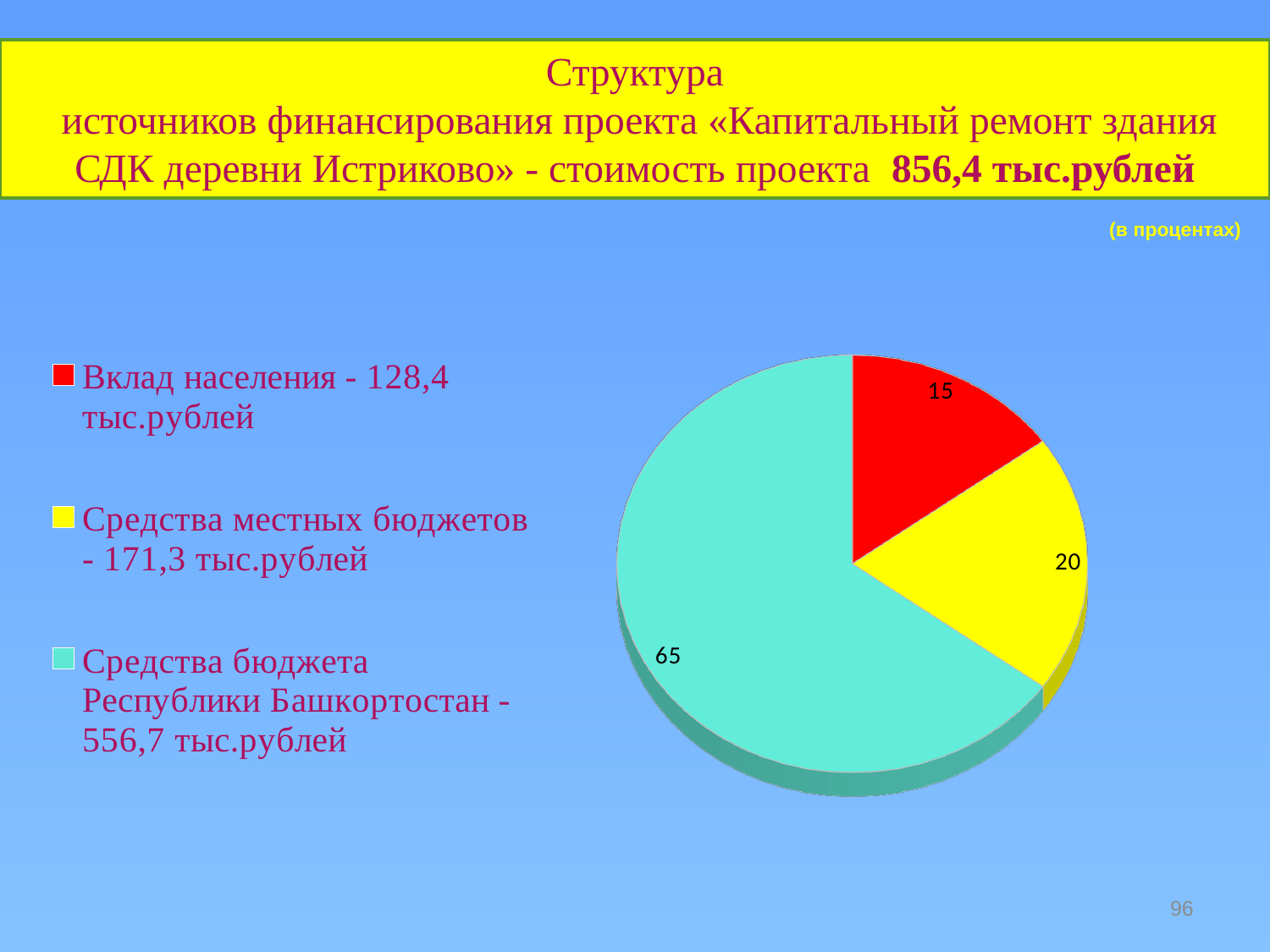
What is the difference in percentage points between the slices for Средства местных бюджетов and Вклад населения? 5 What percentage share does the slice for Средства бюджета Республики Башкортостан have? 65 How many slices does the pie chart have? 3 What kind of chart is shown on the slide? pie chart According to the legend, what amount in тыс.рублей corresponds to Средства бюджета Республики Башкортостан? 556,7 тыс.рублей By how many percentage points does the slice for Средства бюджета Республики Башкортостан exceed the slice for Средства местных бюджетов? 45 What percentage share does the slice for Средства местных бюджетов have? 20 What percentage share does the slice for Вклад населения have? 15 Which funding source has the smallest slice of the pie? Вклад населения Which funding source has the largest slice of the pie? Средства бюджета Республики Башкортостан What colour is the slice for Вклад населения? red Which slice is larger: Вклад населения or Средства местных бюджетов? Средства местных бюджетов